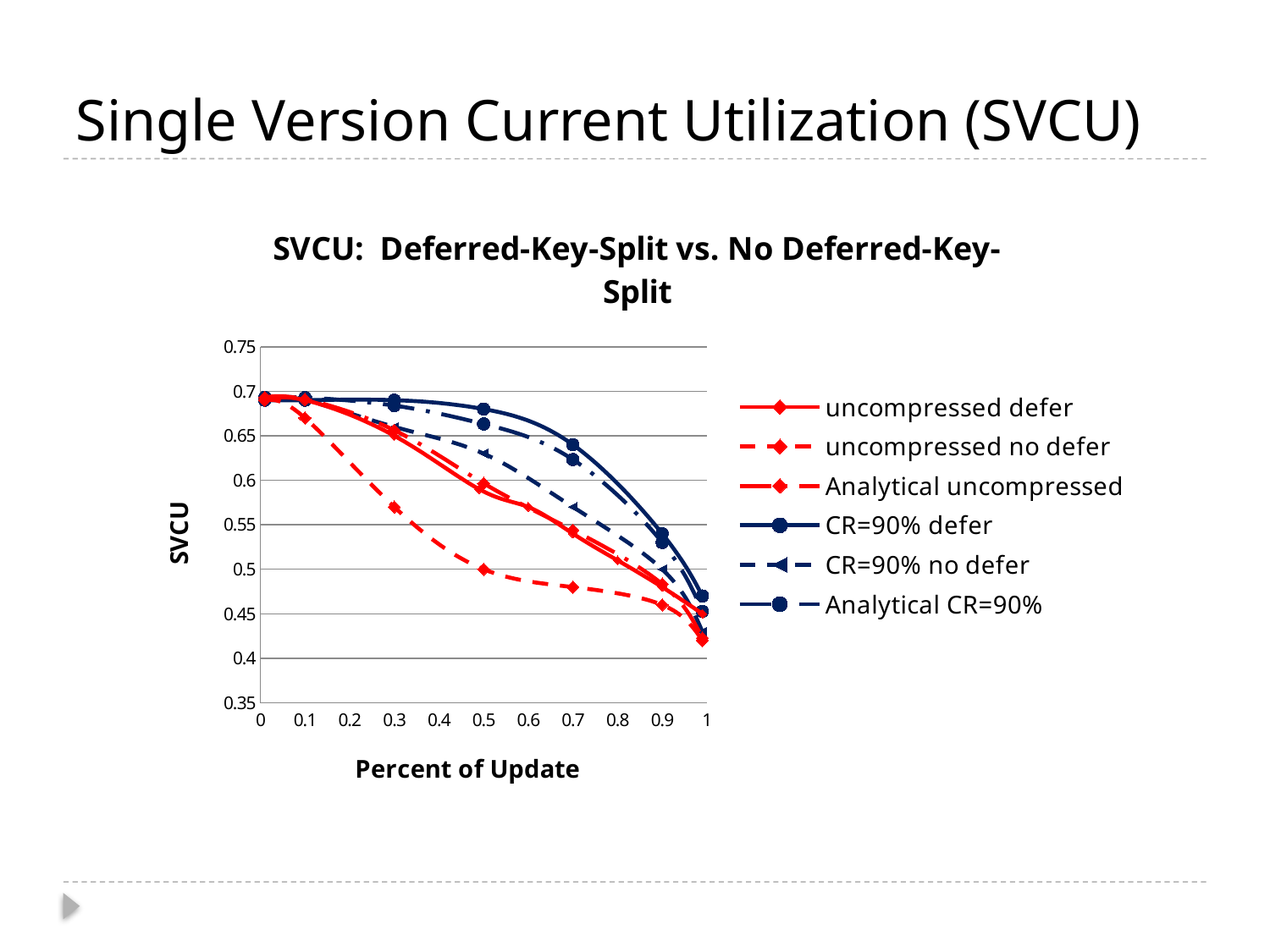
At Percent of Update 0.7, which series has the larger value: 'uncompressed defer' or 'uncompressed no defer'? uncompressed defer What is the label of the x axis? Percent of Update Do the values of the 'uncompressed no defer' series rise or fall as Percent of Update increases? fall How many series does the legend list? 6 Is the value for 'uncompressed defer' at Percent of Update 0.9 greater or less than 0.5? less Is the value for 'CR=90% defer' at Percent of Update 0.7 greater or less than 0.6? greater Is the value for 'uncompressed no defer' at Percent of Update 0.3 greater or less than 0.55? greater What kind of chart is shown on the slide? line chart At Percent of Update 0.5, which series has the larger value: 'CR=90% defer' or 'uncompressed no defer'? CR=90% defer Do the values of the 'CR=90% defer' series rise or fall as Percent of Update increases from 0.5 to 1? fall What is the title of the chart? SVCU: Deferred-Key-Split vs. No Deferred-Key-Split